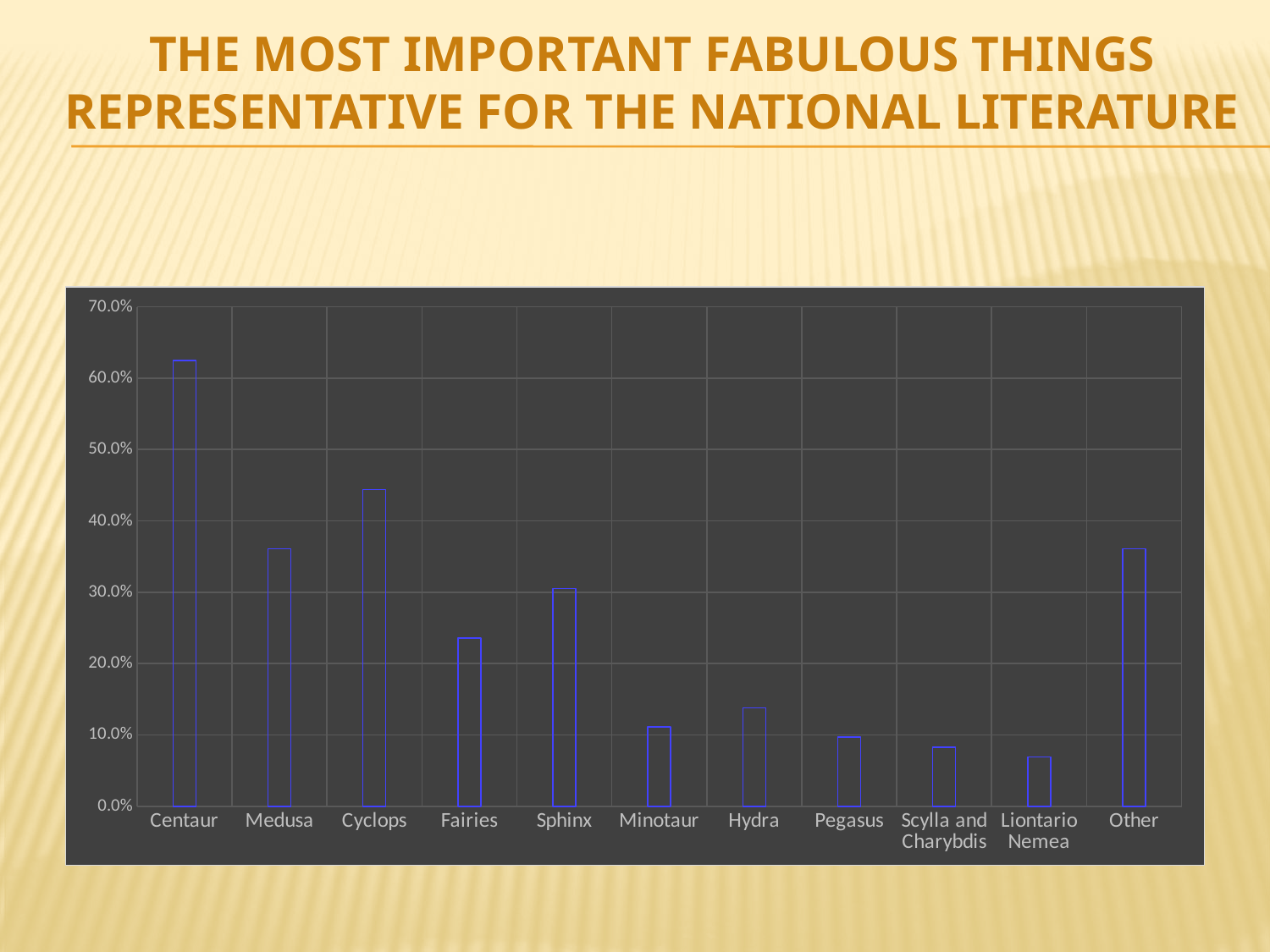
Is the value for Centaur greater or less than 60.0%? greater Which has a larger value, Cyclops or Medusa? Cyclops Which category has the highest value in the chart? Centaur Is the value for Other greater or less than 30.0%? greater What is the title of the slide containing the chart? The Most Important Fabulous Things Representative for the National Literature Which has a larger value, Sphinx or Fairies? Sphinx Which category has the lowest value in the chart? Liontario Nemea Is the value for Fairies greater or less than 20.0%? greater How many categories are shown on the x axis of the chart? 11 What kind of chart is shown on the slide? bar chart